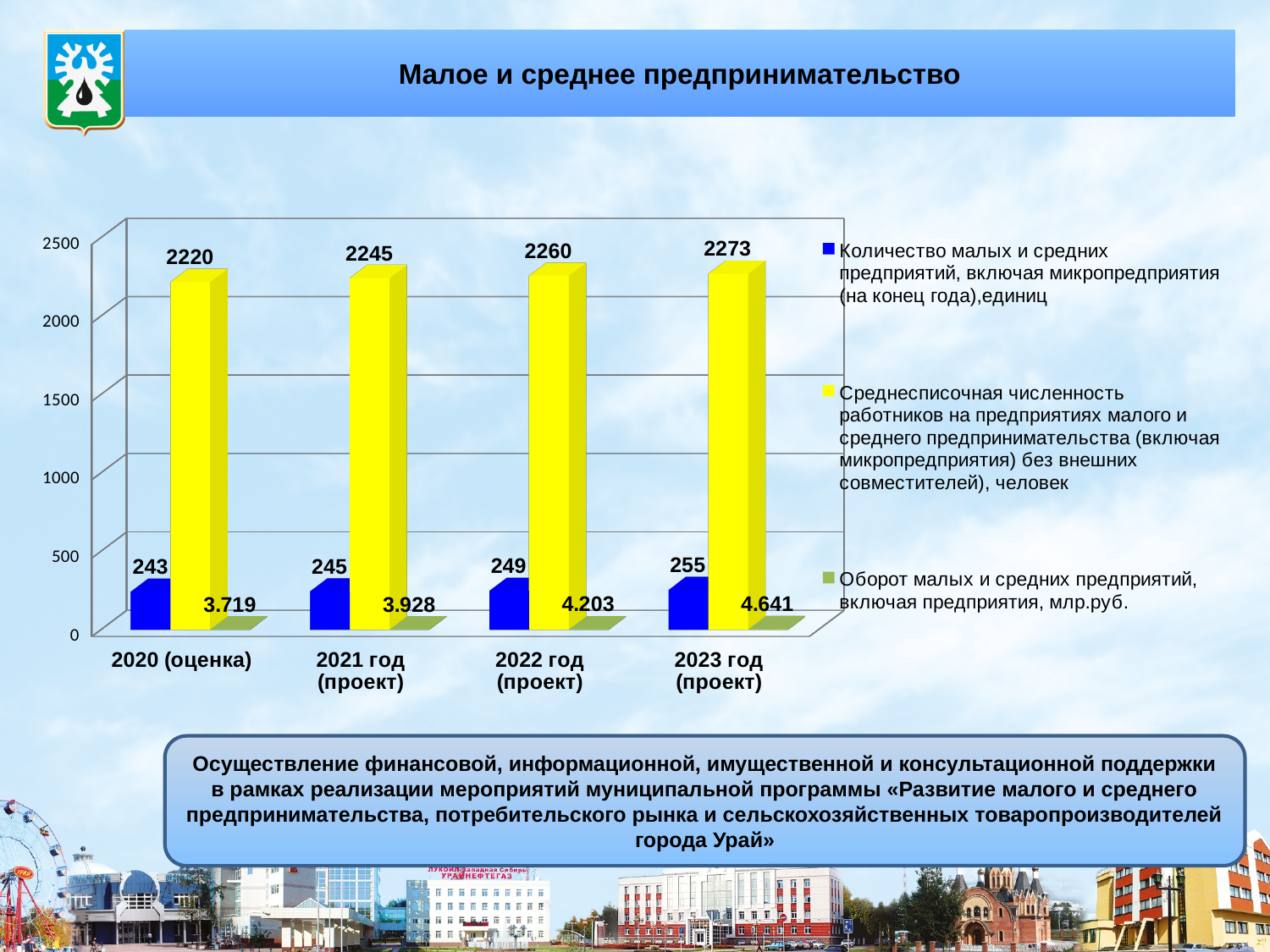
What kind of chart is shown on the slide? bar chart How many series does the legend list? 3 Which is larger: the blue series value for 2021 год (проект) or for 2022 год (проект)? 2022 год (проект) In which category is the blue series (Количество малых и средних предприятий) lowest? 2020 (оценка) What is the value of the yellow series (Среднесписочная численность работников) for 2020 (оценка)? 2220 What is the value of the green series (Оборот малых и средних предприятий, млр.руб.) for 2022 год (проект)? 4.203 How many categories are shown on the x axis? 4 What is the difference between the yellow series values for 2023 год (проект) and 2020 (оценка)? 53 Is the yellow bar for 2021 год (проект) greater or less than 2000? greater What is the value of the blue series (Количество малых и средних предприятий) for 2023 год (проект)? 255 Does the green series (Оборот малых и средних предприятий) rise or fall from 2020 (оценка) to 2023 год (проект)? rise In which category does the yellow series (Среднесписочная численность работников) reach its highest value? 2023 год (проект)